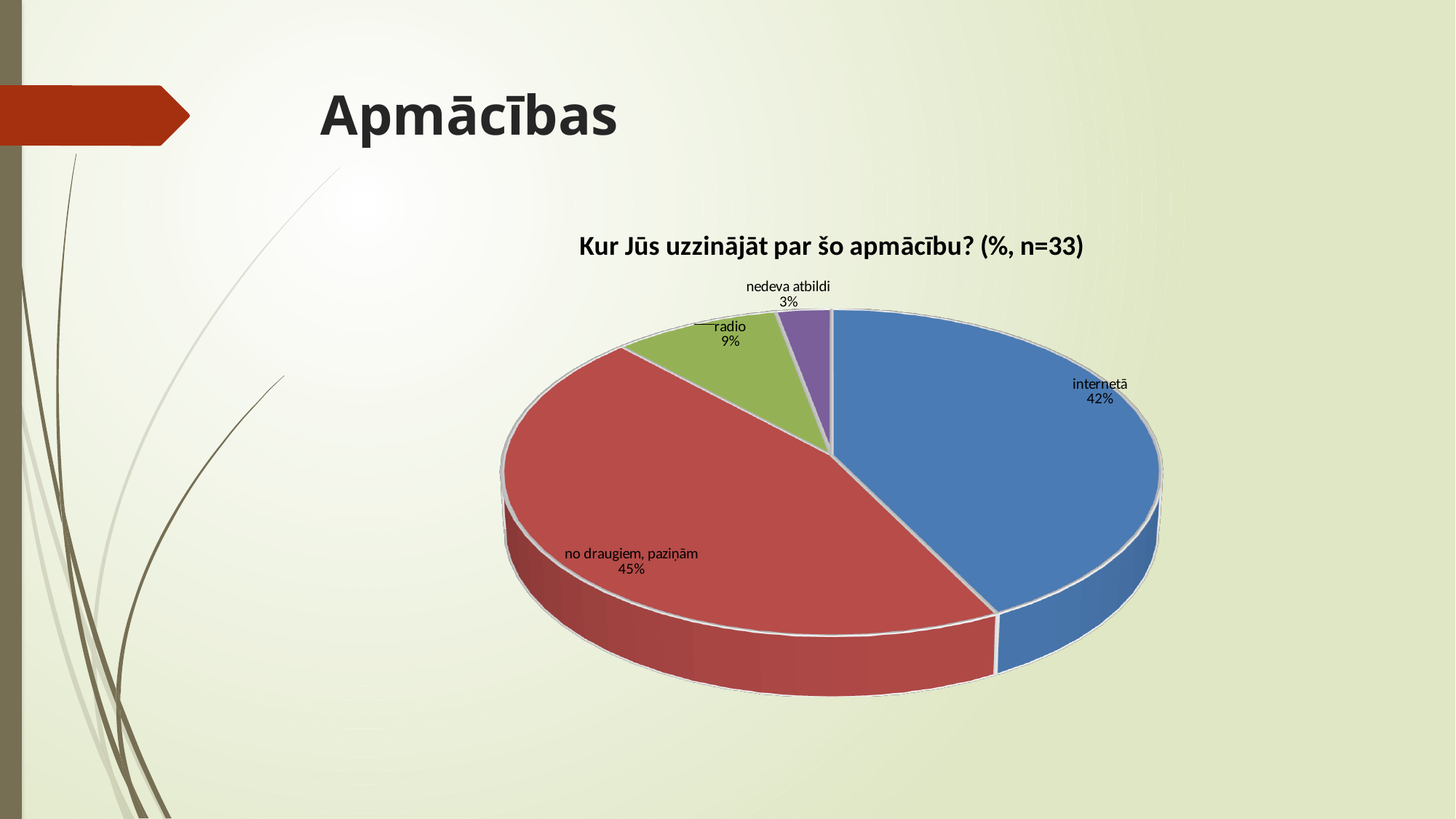
What is the value shown for "radio"? 9% What is the value shown for "nedeva atbildi"? 3% What is the difference between the shares for "no draugiem, paziņām" and "internetā"? 3% What kind of chart is shown on the slide? pie chart Which is larger, the share for "radio" or the share for "nedeva atbildi"? radio What share of the pie does "no draugiem, paziņām" have? 45% What share of the pie does "internetā" have? 42% How many categories are shown in the pie chart? 4 What is the difference between the shares for "radio" and "nedeva atbildi"? 6% Which category has the smallest slice? nedeva atbildi Which category has the largest slice? no draugiem, paziņām What is the title of the chart? Kur Jūs uzzinājāt par šo apmācību? (%, n=33)